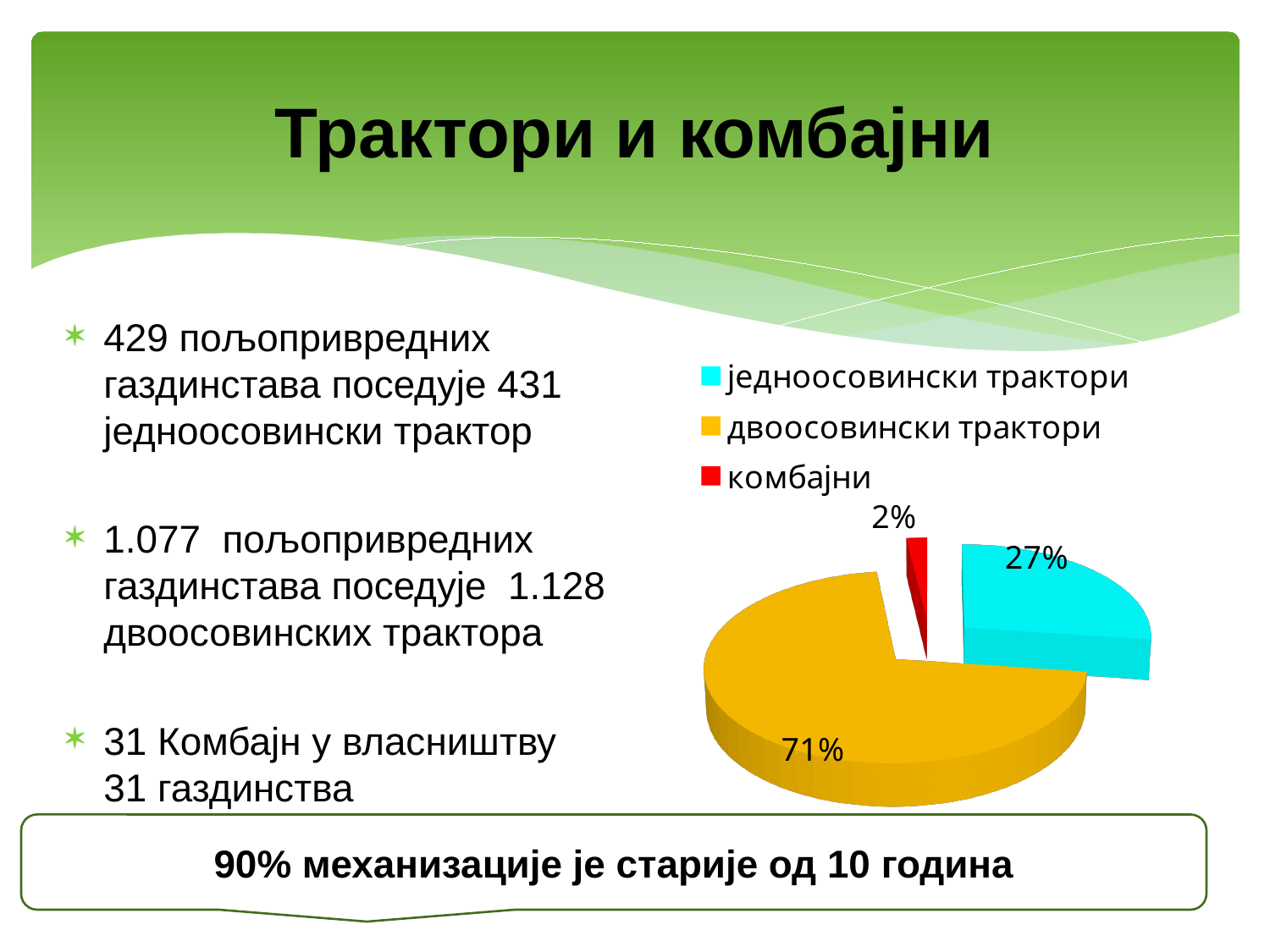
Which category has the smallest slice of the pie? комбајни How many slices does the pie chart have? 3 How many entries does the legend list? 3 What is the difference in percentage points between the slices for двоосовински трактори and једноосовински трактори? 44 What share of the pie does the slice for једноосовински трактори represent? 27% What kind of chart is shown on the slide? pie chart What share of the pie does the slice for комбајни represent? 2% What colour is the slice for комбајни? red Which slice is larger, једноосовински трактори or комбајни? једноосовински трактори Which category has the largest slice of the pie? двоосовински трактори What share of the pie does the slice for двоосовински трактори represent? 71% What colour is the slice for једноосовински трактори? cyan